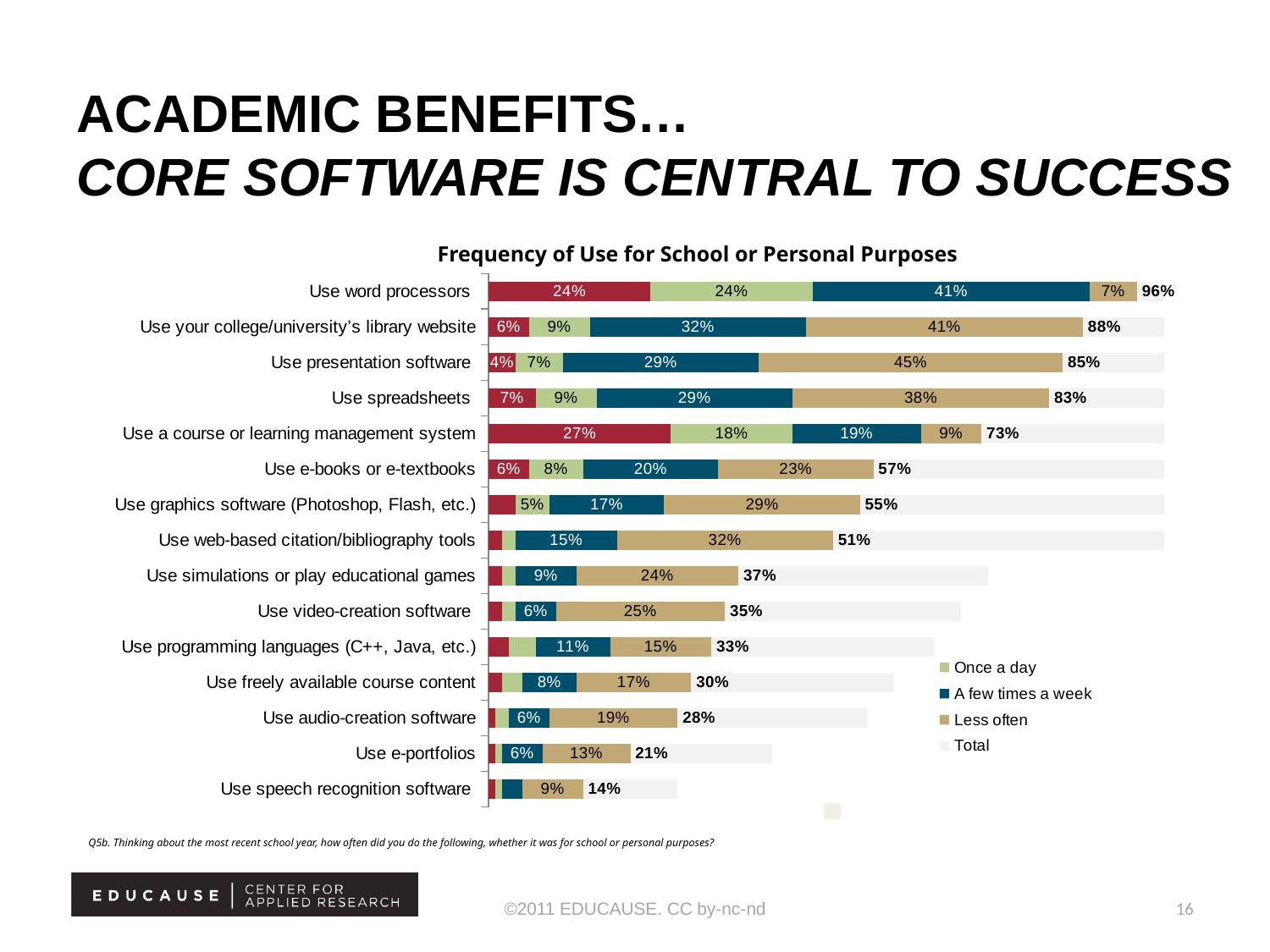
Which has a larger total percentage: 'Use e-portfolios' or 'Use audio-creation software'? Use audio-creation software What is the 'A few times a week' value for 'Use your college/university's library website'? 32% How many categories (activities) are listed on the chart? 15 What is the total percentage shown for 'Use word processors'? 96% What is the 'Less often' value for 'Use presentation software'? 45% Which activity has the lowest total percentage? Use speech recognition software What is the difference between the total for 'Use spreadsheets' and the total for 'Use e-books or e-textbooks'? 26% What is the total percentage shown for 'Use speech recognition software'? 14% How many entries does the chart's legend list? 4 Which activity has the highest total percentage? Use word processors What is the title of the chart? Frequency of Use for School or Personal Purposes What type of chart is shown on the slide? bar chart